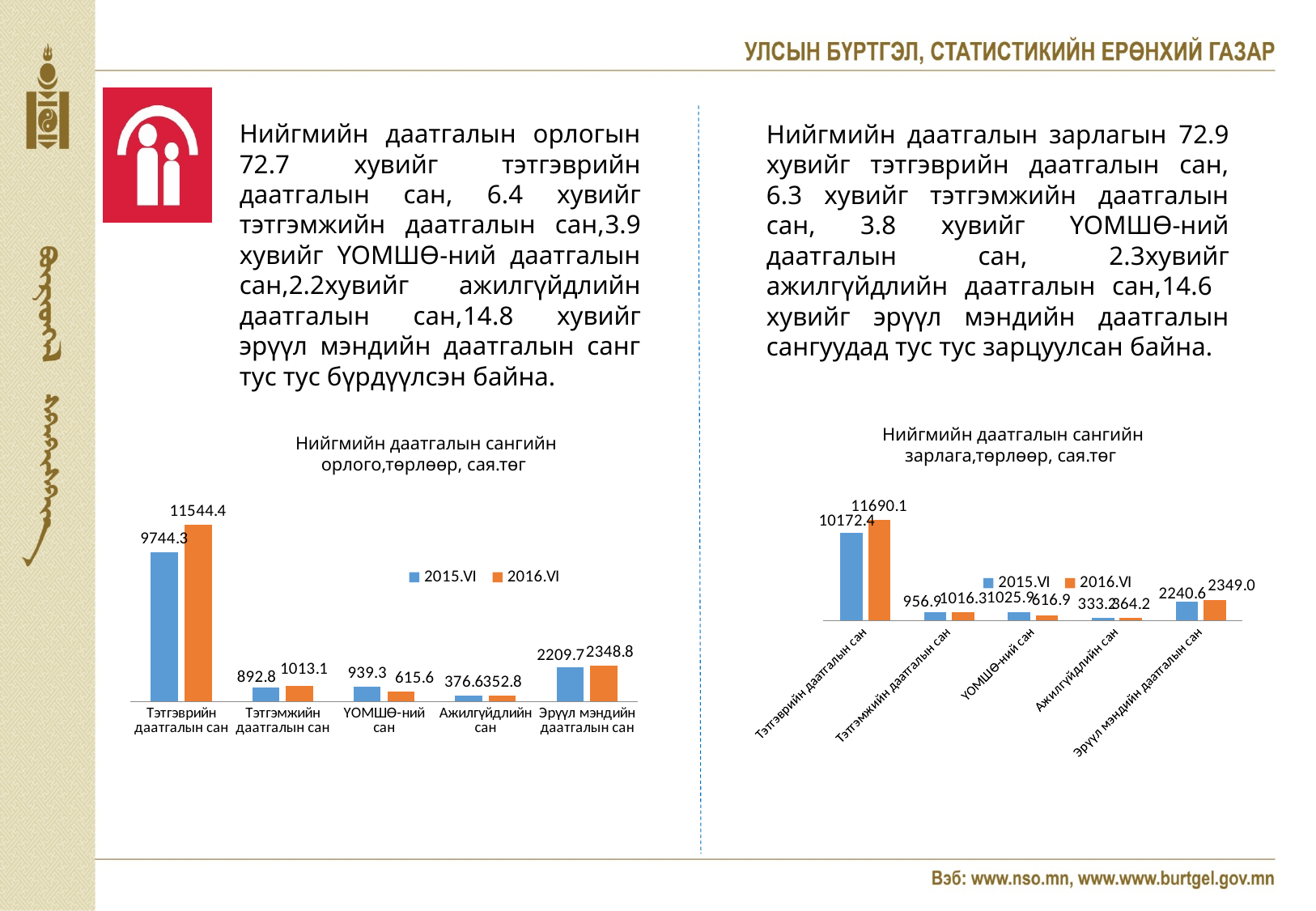
In the right chart (Нийгмийн даатгалын сангийн зарлага), what is the 2015.VI value for Тэтгэврийн даатгалын сан? 10172.4 How many categories are shown on the x axis of the right chart (Нийгмийн даатгалын сангийн зарлага)? 5 In the right chart (Нийгмийн даатгалын сангийн зарлага), which is larger for ҮОМШӨ-ний сан: 2015.VI or 2016.VI? 2015.VI What type of chart is the right chart (Нийгмийн даатгалын сангийн зарлага)? Bar chart In the right chart (Нийгмийн даатгалын сангийн зарлага), what is the 2016.VI value for Эрүүл мэндийн даатгалын сан? 2349.0 In the left chart (Нийгмийн даатгалын сангийн орлого), which category has the lowest 2016.VI value? Ажилгүйдлийн сан In the left chart (Нийгмийн даатгалын сангийн орлого), what is the difference between the 2016.VI and 2015.VI values for Тэтгэврийн даатгалын сан? 1800.1 In the left chart (Нийгмийн даатгалын сангийн орлого), what is the 2015.VI value for Эрүүл мэндийн даатгалын сан? 2209.7 How many series does the legend of the left chart (Нийгмийн даатгалын сангийн орлого) list? 2 In the left chart (Нийгмийн даатгалын сангийн орлого), what is the 2016.VI value for Тэтгэврийн даатгалын сан? 11544.4 In the right chart (Нийгмийн даатгалын сангийн зарлага), which category has the highest 2016.VI value? Тэтгэврийн даатгалын сан In the left chart (Нийгмийн даатгалын сангийн орлого), which is larger for ҮОМШӨ-ний сан: 2015.VI or 2016.VI? 2015.VI